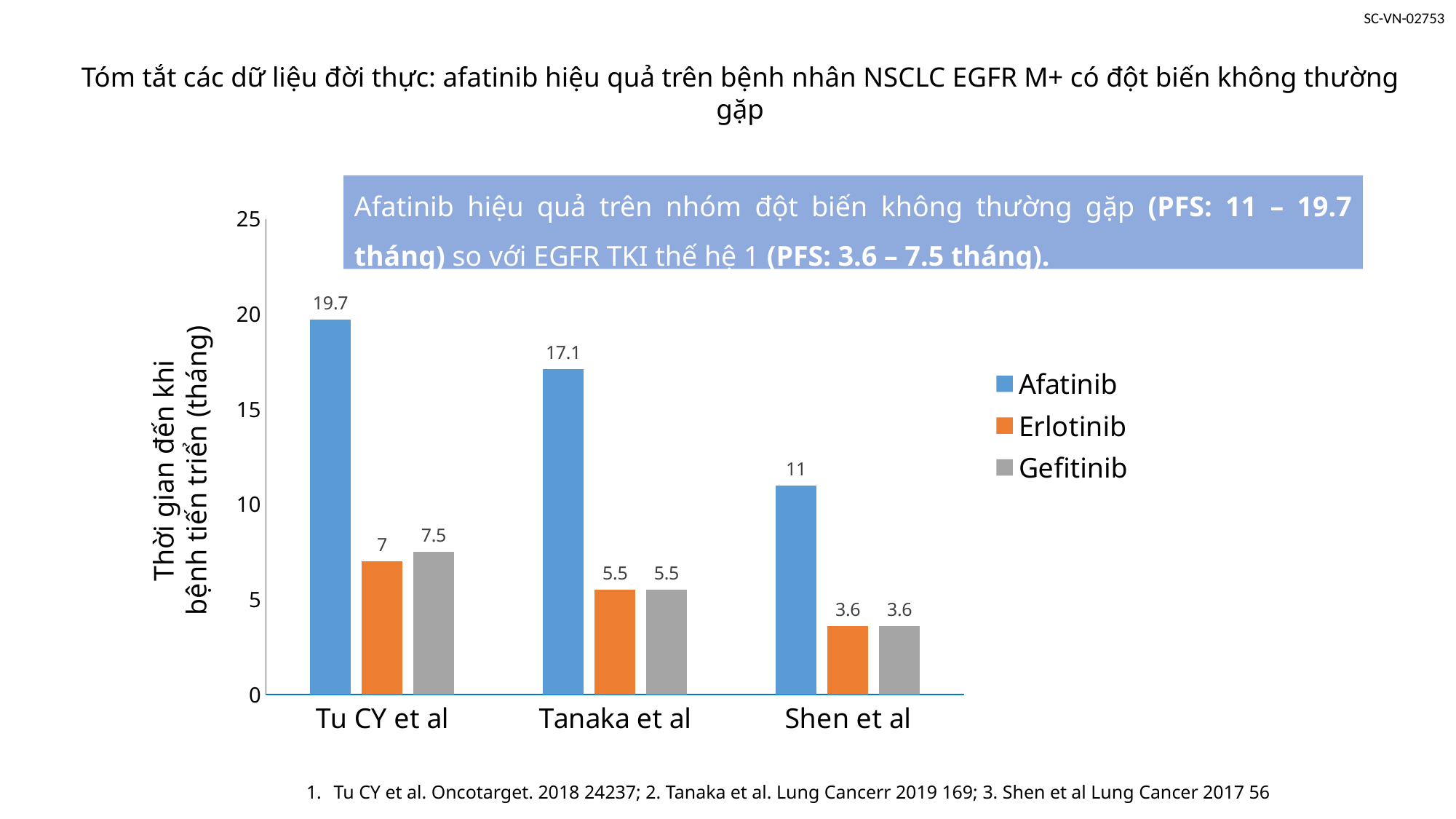
What is the difference between the Afatinib and Gefitinib values for Tu CY et al? 12.2 What is the Erlotinib value for Tanaka et al? 5.5 What is the Afatinib value for Tu CY et al? 19.7 Which study has the lowest Erlotinib value? Shen et al Do the Afatinib values rise or fall from Tu CY et al to Shen et al? Fall How many series does the legend list? 3 What is the Gefitinib value for Shen et al? 3.6 How many studies are shown on the x axis? 3 Which study has the highest Afatinib value? Tu CY et al What is the difference between the Afatinib values for Tanaka et al and Shen et al? 6.1 What kind of chart is shown on the slide? Bar chart Which is larger for Tu CY et al, the Erlotinib value or the Gefitinib value? Gefitinib